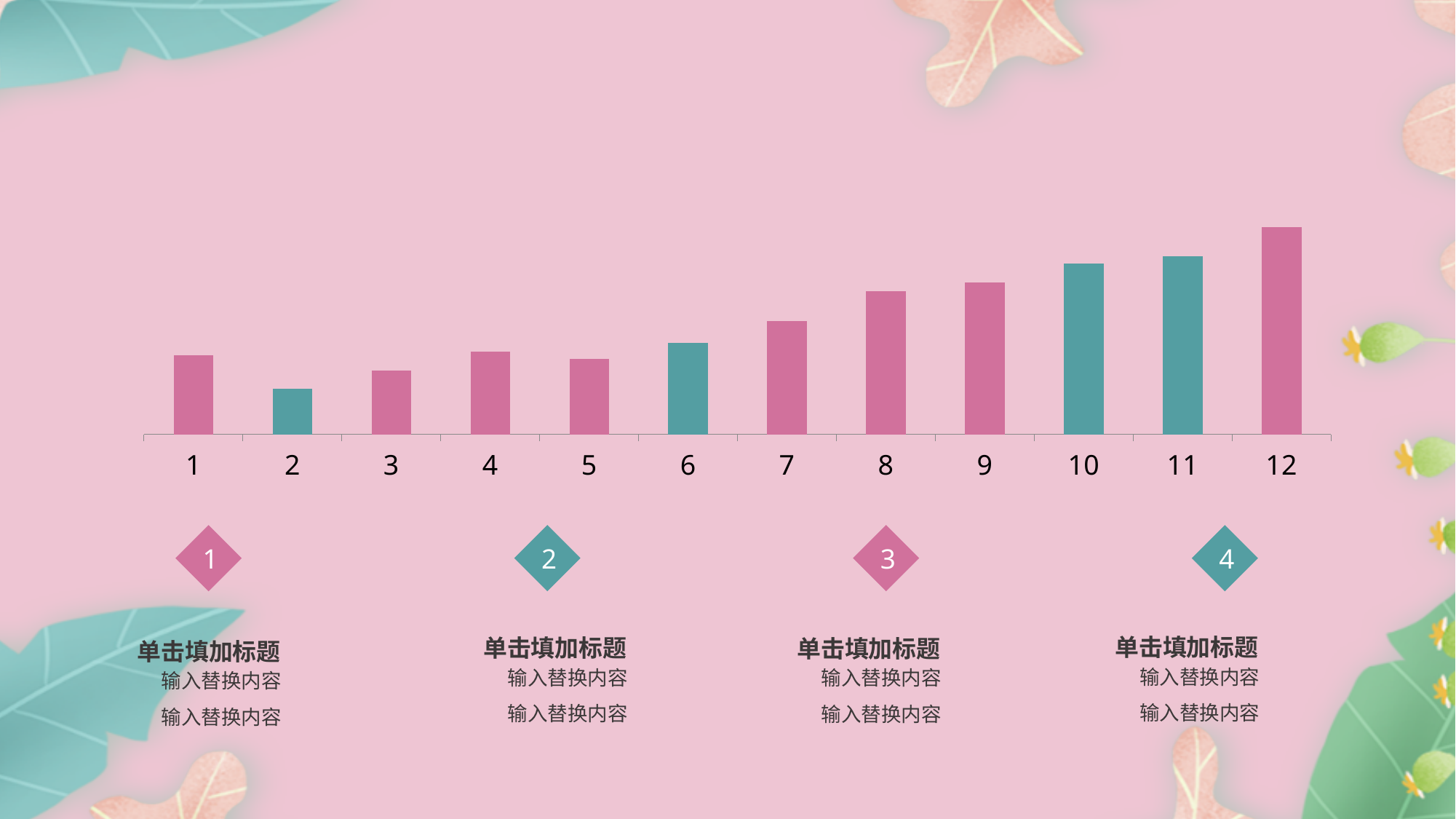
Do the bar heights generally rise or fall from category 1 to category 12? rise Which category has the tallest bar in the chart? 12 Which bar is taller, category 12 or category 8? 12 What kind of chart is shown on the slide? bar chart Which category has the shortest bar in the chart? 2 How many bars in the chart are coloured teal rather than pink? 4 Which bar is taller, category 3 or category 7? 7 Which categories have teal-coloured bars in the chart? 2, 6, 10, 11 Which bar is taller, category 6 or category 9? 9 How many categories are plotted along the x axis of the chart? 12